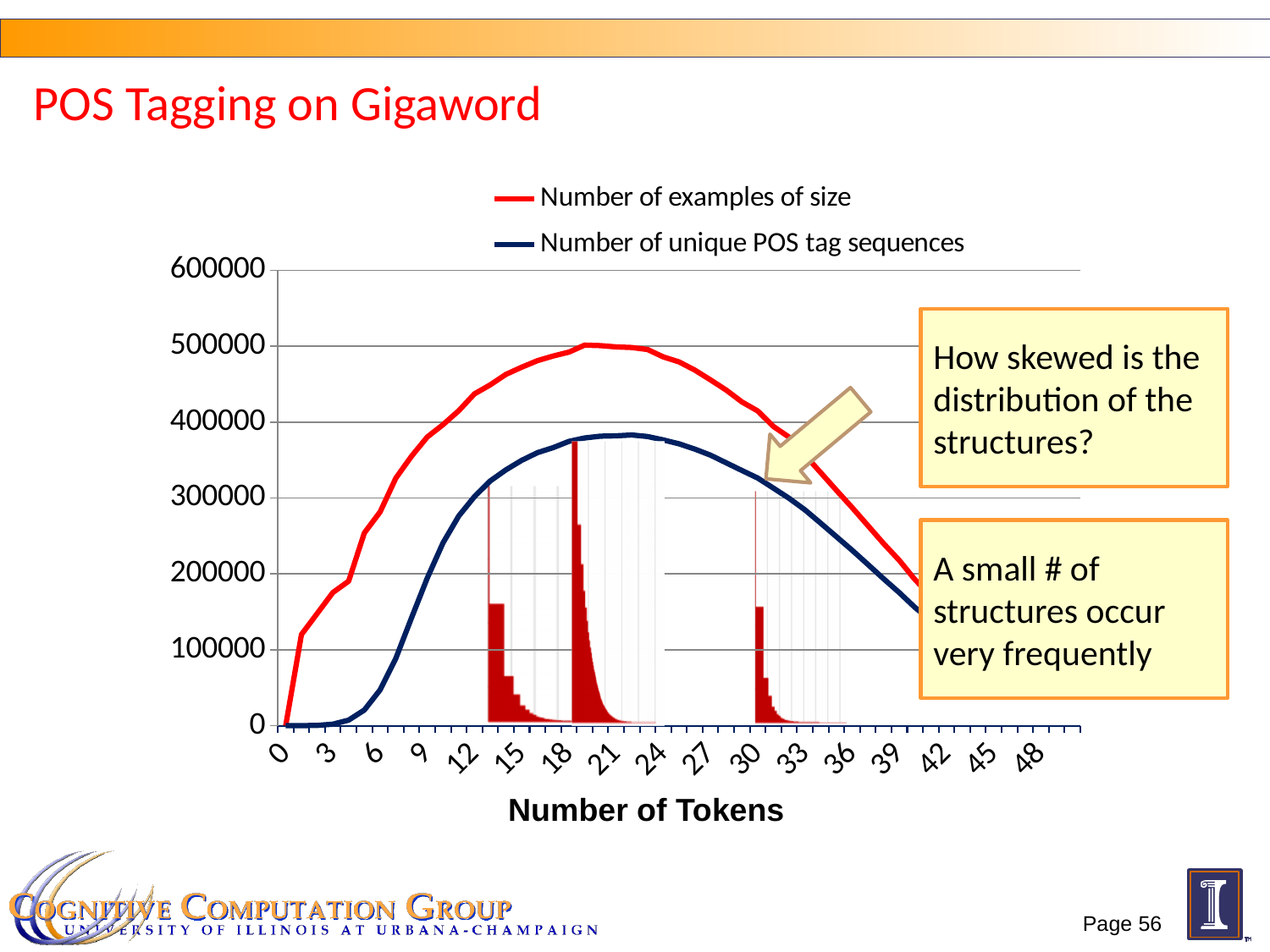
Is the value of Number of examples of size at 3 tokens greater or less than 100000? greater Does the Number of examples of size series rise or fall between 0 and 18 tokens? rise What kind of chart is shown on the slide? line chart How many series does the legend list? 2 Does the Number of unique POS tag sequences series rise or fall between 30 and 42 tokens? fall At 21 tokens, which series has the larger value: Number of examples of size or Number of unique POS tag sequences? Number of examples of size Is the value of Number of unique POS tag sequences at 3 tokens greater or less than 100000? less Is the value of Number of examples of size at 27 tokens greater or less than 400000? greater Which series is drawn in red? Number of examples of size What is the title of the x axis? Number of Tokens